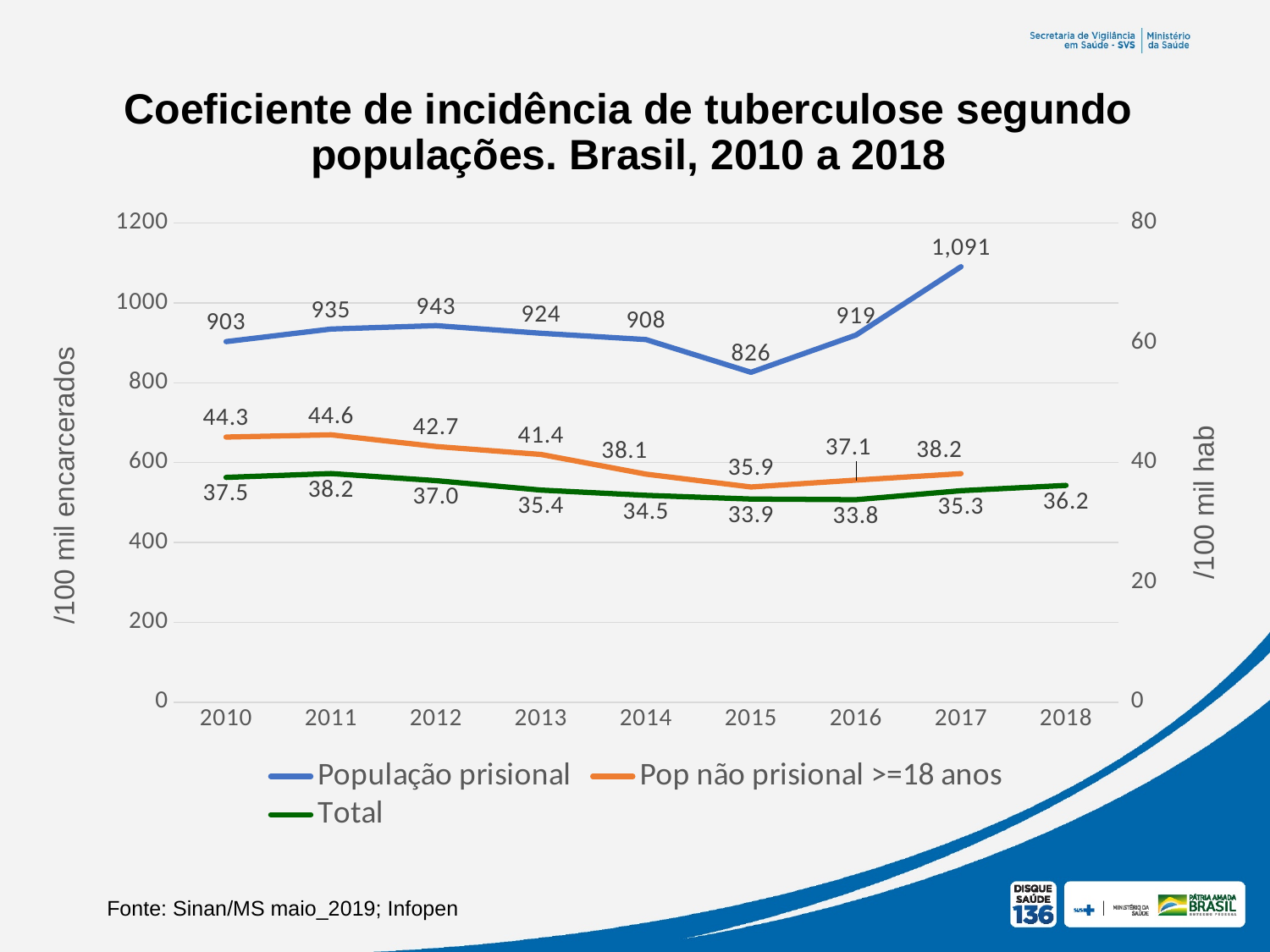
How many years are shown on the x axis? 9 Which is larger, the Total value for 2011 or for 2014? 2011 What is the value for Total in 2018? 36.2 What is the value for Pop não prisional >=18 anos in 2011? 44.6 In which year is the value for Total lowest? 2016 In which year is the value for Pop não prisional >=18 anos highest? 2011 What is the difference between the População prisional values for 2017 and 2015? 265 Does the Pop não prisional >=18 anos series rise or fall from 2011 to 2015? Fall How many series does the legend list? 3 What type of chart is shown on the slide? Line chart In which year is the value for População prisional lowest? 2015 What is the value for População prisional in 2017? 1,091